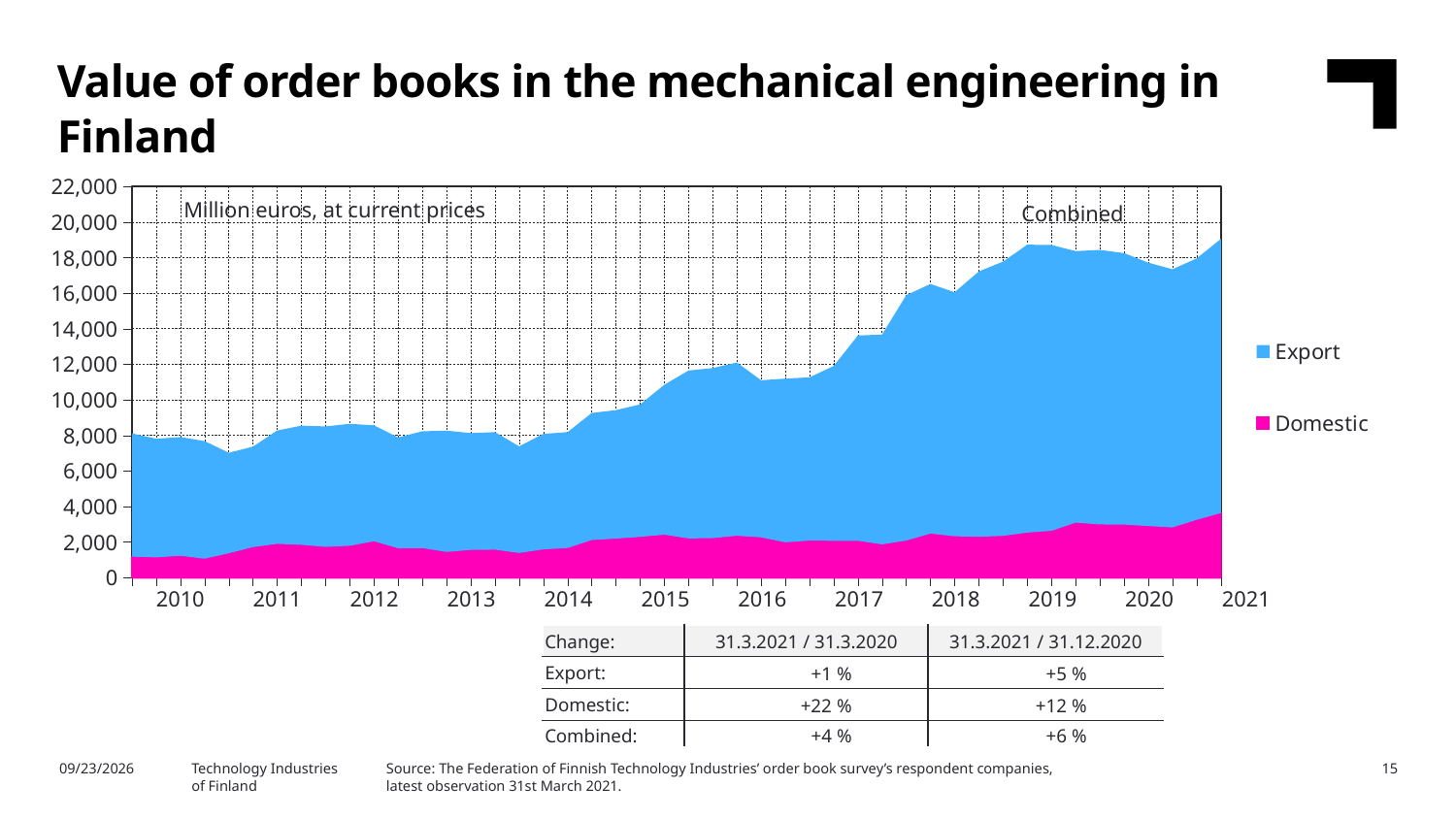
What unit is stated in the label inside the chart area? Million euros, at current prices Which two series are listed in the chart legend? Export and Domestic Is the Domestic value at the start of 2010 greater or less than 2,000? less Which series is larger throughout the chart, Export or Domestic? Export How many year labels are shown on the x axis? 12 What kind of chart is shown on the slide? Stacked area chart What is the highest value shown on the y axis? 22,000 Overall, does the combined value of order books rise or fall from 2010 to 2021? rise How many series does the chart legend list? 2 Is the combined value of order books at the start of 2021 greater or less than 16,000? greater Is the Domestic value at the end of the series in 2021 greater or less than 4,000? less